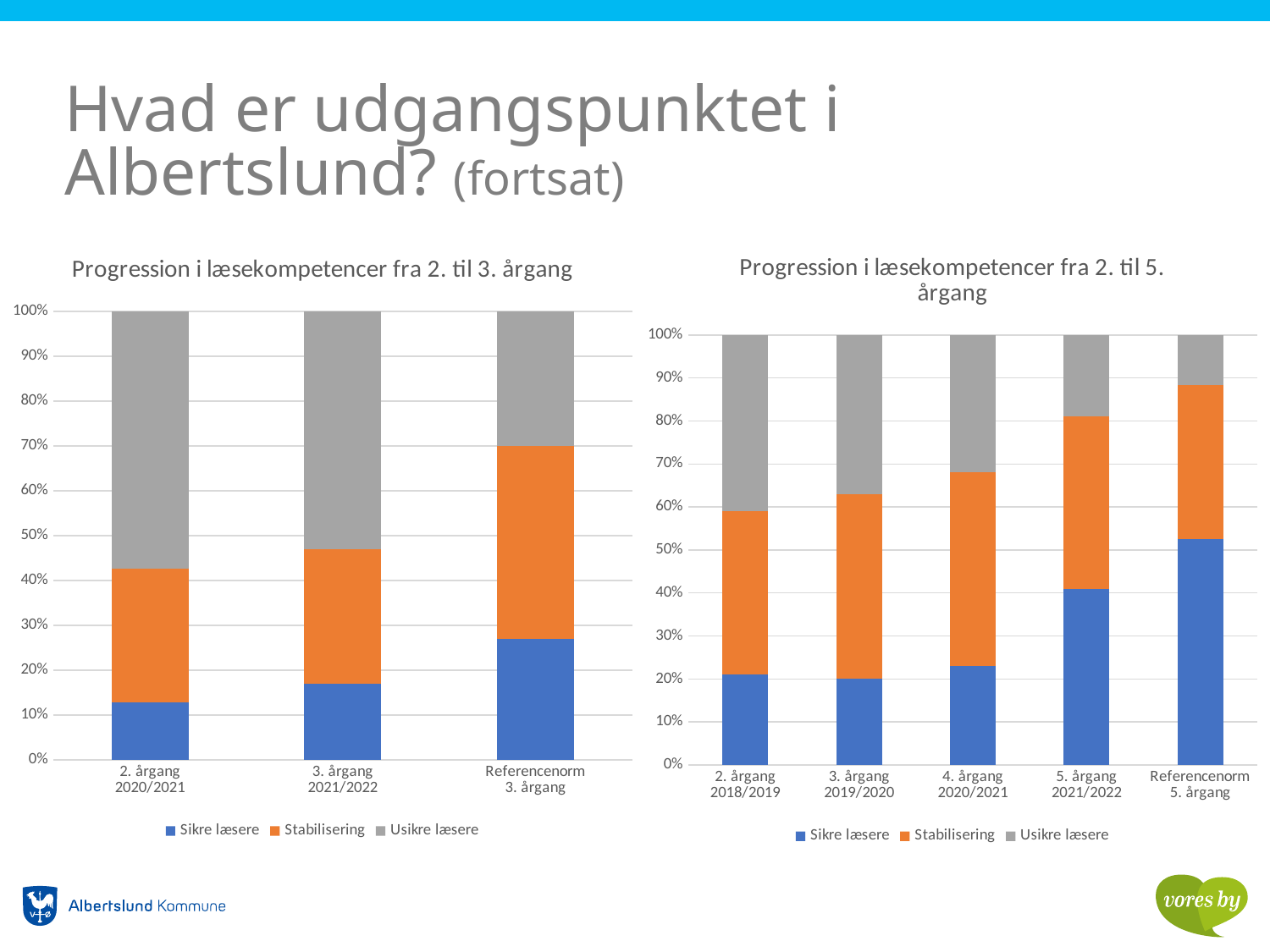
In the right chart, 'Progression i læsekompetencer fra 2. til 5. årgang', is the value for Sikre læsere for 5. årgang 2021/2022 greater or less than 30%? greater In the right chart, 'Progression i læsekompetencer fra 2. til 5. årgang', which has the larger share of Sikre læsere: 4. årgang 2020/2021 or 5. årgang 2021/2022? 5. årgang 2021/2022 In the right chart, 'Progression i læsekompetencer fra 2. til 5. årgang', does the share of Usikre læsere rise or fall from left to right across the categories? Fall In the left chart, 'Progression i læsekompetencer fra 2. til 3. årgang', which category has the lowest share of Sikre læsere? 2. årgang 2020/2021 How many series does the legend of the right chart, 'Progression i læsekompetencer fra 2. til 5. årgang', list? 3 In the left chart, 'Progression i læsekompetencer fra 2. til 3. årgang', is the value for Sikre læsere for 2. årgang 2020/2021 greater or less than 20%? less What kind of chart is the left chart, 'Progression i læsekompetencer fra 2. til 3. årgang'? Stacked bar chart How many categories are shown on the x axis of the left chart, 'Progression i læsekompetencer fra 2. til 3. årgang'? 3 In the right chart, 'Progression i læsekompetencer fra 2. til 5. årgang', which category has the highest share of Sikre læsere? Referencenorm 5. årgang How many categories are shown on the x axis of the right chart, 'Progression i læsekompetencer fra 2. til 5. årgang'? 5 In the left chart, 'Progression i læsekompetencer fra 2. til 3. årgang', which category has the highest share of Sikre læsere? Referencenorm 3. årgang What are the three legend entries of the left chart, 'Progression i læsekompetencer fra 2. til 3. årgang'? Sikre læsere, Stabilisering, Usikre læsere